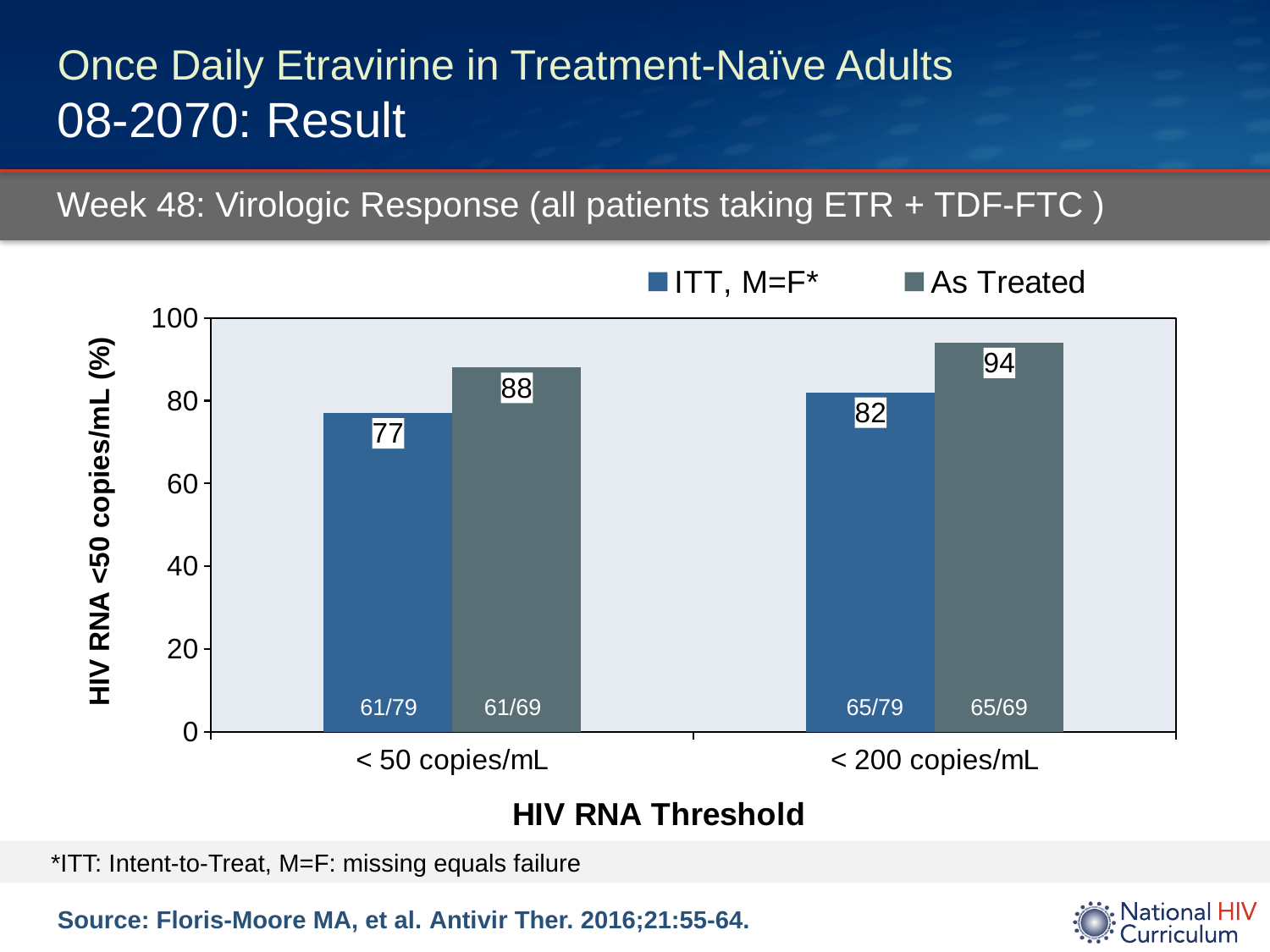
Which bar has the lowest value on the chart? ITT, M=F*, < 50 copies/mL What is the As Treated value for < 200 copies/mL? 94 Which is larger for < 200 copies/mL: ITT, M=F* or As Treated? As Treated What is the ITT, M=F* value for < 200 copies/mL? 82 What is the difference between the As Treated and ITT, M=F* values for < 50 copies/mL? 11 What is the As Treated value for < 50 copies/mL? 88 What kind of chart is shown on the slide? Bar chart What is the ITT, M=F* value for < 50 copies/mL? 77 How many categories are shown on the x axis? 2 Which bar has the highest value on the chart? As Treated, < 200 copies/mL How many series does the legend list? 2 What is the x-axis title of the chart? HIV RNA Threshold